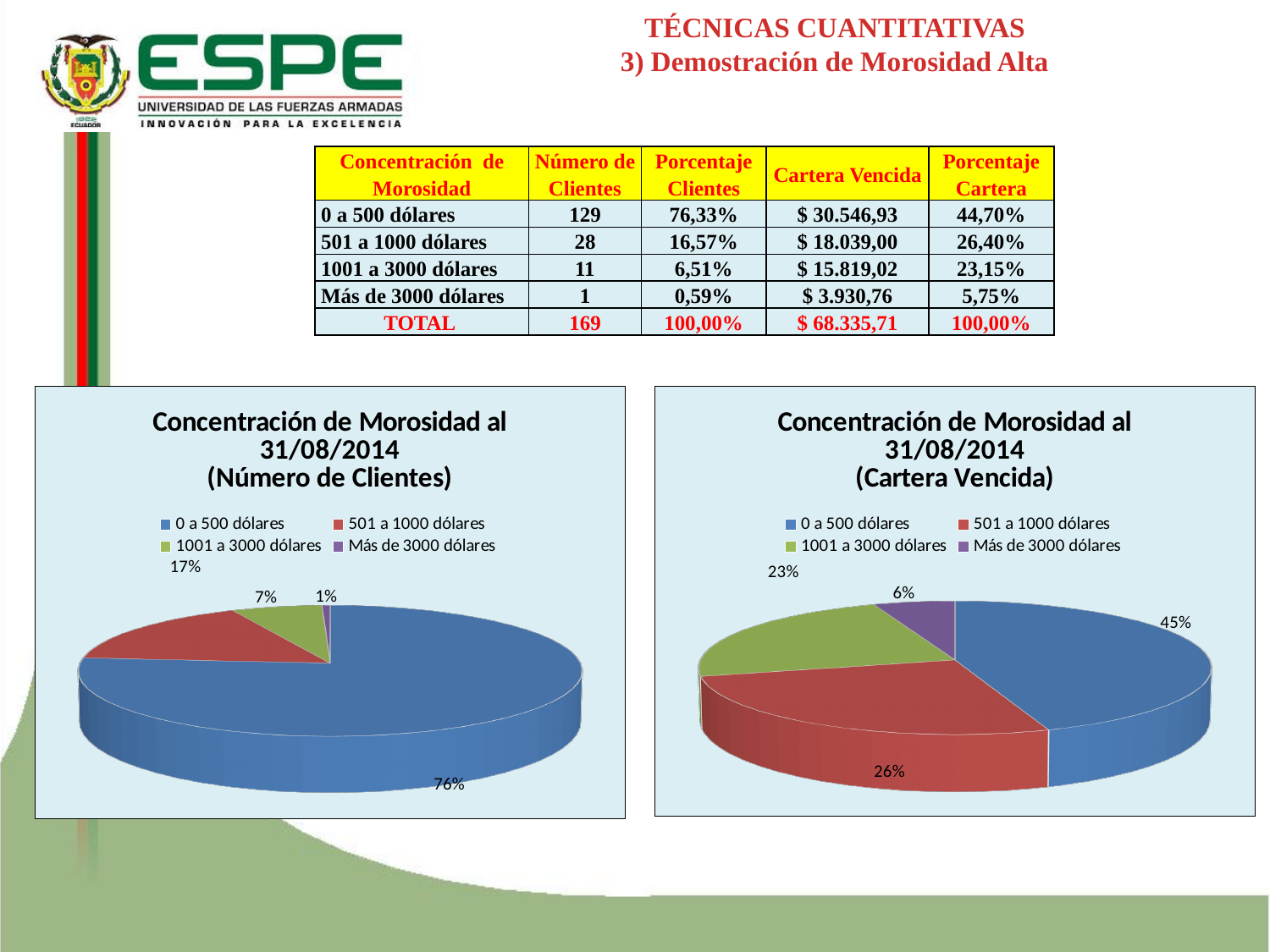
In the 'Concentración de Morosidad al 31/08/2014 (Número de Clientes)' chart, what share does '501 a 1000 dólares' have? 17% How many categories does the legend of the 'Concentración de Morosidad al 31/08/2014 (Cartera Vencida)' chart list? 4 What kind of chart is the 'Concentración de Morosidad al 31/08/2014 (Número de Clientes)' chart? Pie chart In the 'Concentración de Morosidad al 31/08/2014 (Número de Clientes)' chart, which category has the largest slice? 0 a 500 dólares In the 'Concentración de Morosidad al 31/08/2014 (Número de Clientes)' chart, what share does '0 a 500 dólares' have? 76% In the 'Concentración de Morosidad al 31/08/2014 (Cartera Vencida)' chart, what colour is the '501 a 1000 dólares' slice? Red In the 'Concentración de Morosidad al 31/08/2014 (Cartera Vencida)' chart, what share does '0 a 500 dólares' have? 45% In the 'Concentración de Morosidad al 31/08/2014 (Número de Clientes)' chart, what share does 'Más de 3000 dólares' have? 1% In the 'Concentración de Morosidad al 31/08/2014 (Cartera Vencida)' chart, what share does '1001 a 3000 dólares' have? 23% In the 'Concentración de Morosidad al 31/08/2014 (Cartera Vencida)' chart, what is the difference between the shares of '0 a 500 dólares' and '501 a 1000 dólares'? 19% In the 'Concentración de Morosidad al 31/08/2014 (Número de Clientes)' chart, which is larger: the share of '501 a 1000 dólares' or '1001 a 3000 dólares'? 501 a 1000 dólares In the 'Concentración de Morosidad al 31/08/2014 (Cartera Vencida)' chart, which category has the smallest slice? Más de 3000 dólares